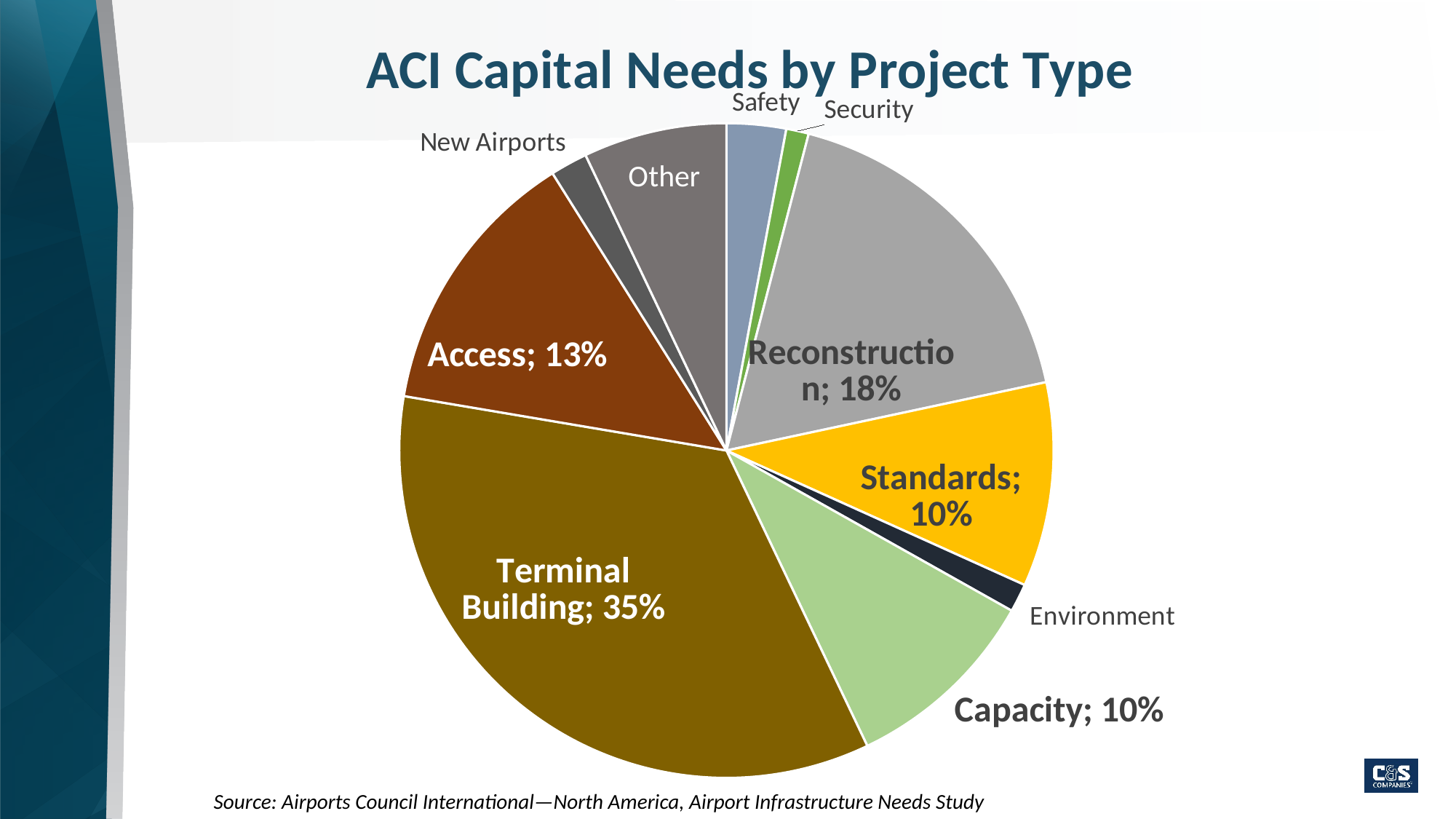
What share of the pie does Standards represent? 10% Which has a larger share, Reconstruction or Access? Reconstruction What percentage of capital needs is for Terminal Building? 35% What type of chart is shown on the slide? Pie chart What is the difference in percentage points between Terminal Building and Reconstruction? 17 percentage points What percentage of capital needs is for Reconstruction? 18% How many slices does the pie chart have? 10 What is the title of the chart? ACI Capital Needs by Project Type What percentage of capital needs is for Access? 13% Which slice is labelled 'Other' on the chart, in terms of colour? The grey slice What share of the pie does Capacity represent? 10% Which project type has the largest share of capital needs? Terminal Building